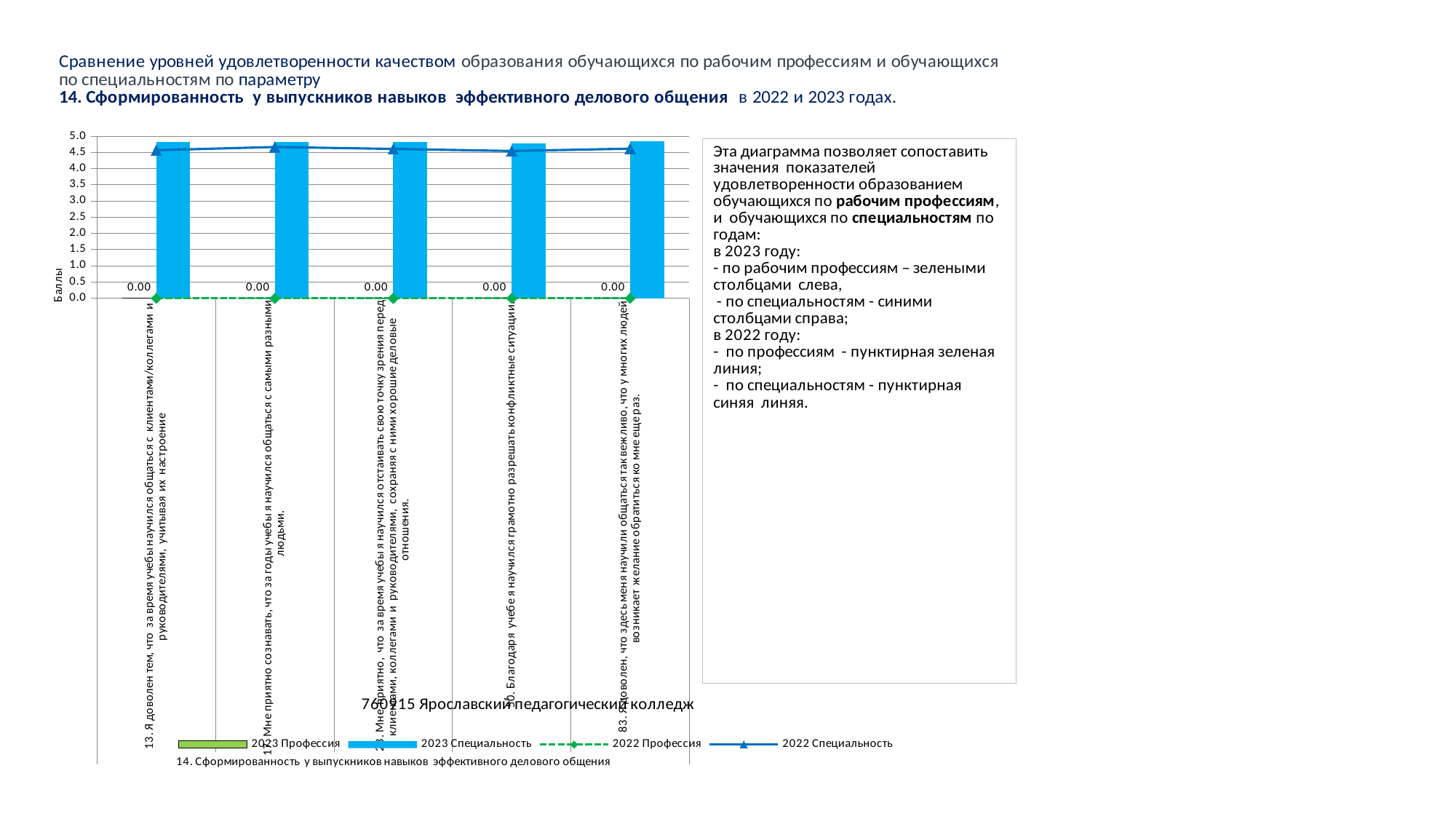
Is the 2023 Специальность value for category 83 greater or less than 4.5? greater Which legend entry is drawn as a dashed green line? 2022 Профессия Is the 2022 Специальность value for category 83 greater or less than 4.0? greater How many categories (questions) are plotted along the x axis of the chart? 5 What is the title of the vertical axis of the chart? Баллы What is the value of the 2023 Профессия series for category 83 ("Я доволен, что здесь меня научили общаться так вежливо...")? 0.00 Is the 2023 Специальность value for category 13 greater or less than 4.0? greater For category 83, which is larger: the 2023 Специальность value or the 2023 Профессия value? 2023 Специальность How many series does the chart legend list? 4 What is the value of the 2023 Профессия series for category 13 ("Я доволен тем, что за время учебы научился общаться с клиентами/коллегами и руководителями...")? 0.00 What kind of chart is shown on the slide? bar chart combined with line series